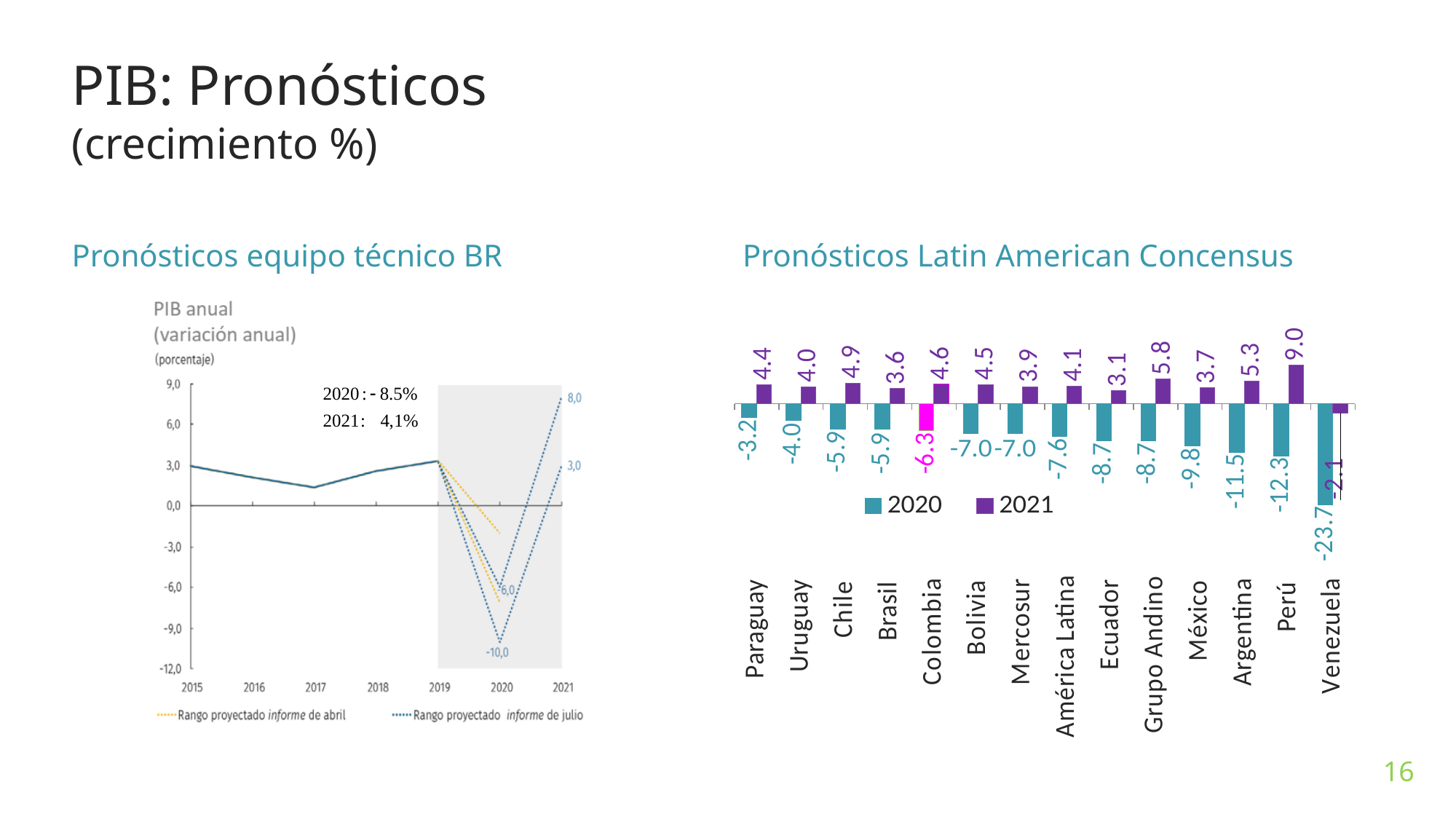
In the Pronósticos Latin American Concensus chart, what is the 2020 value for Colombia? -6.3 In the PIB anual chart on the left, what is the lowest labelled value of the projected range for 2020? -10,0 In the Pronósticos Latin American Concensus chart, which is the only category with a negative 2021 value? Venezuela In the Pronósticos Latin American Concensus chart, what is the difference between the 2021 values for Perú and Ecuador? 5.9 What kind of chart is the PIB anual chart on the left? Line chart How many series does the legend of the Pronósticos Latin American Concensus chart list? 2 In the Pronósticos Latin American Concensus chart, which category has the highest 2021 value? Perú How many categories are shown in the Pronósticos Latin American Concensus chart? 14 In the Pronósticos Latin American Concensus chart, which has the larger 2021 value, Chile or Brasil? Chile In the Pronósticos Latin American Concensus chart, what is the 2021 value for Perú? 9.0 In the Pronósticos Latin American Concensus chart, which category has the lowest 2020 value? Venezuela What kind of chart is the Pronósticos Latin American Concensus chart? Bar chart